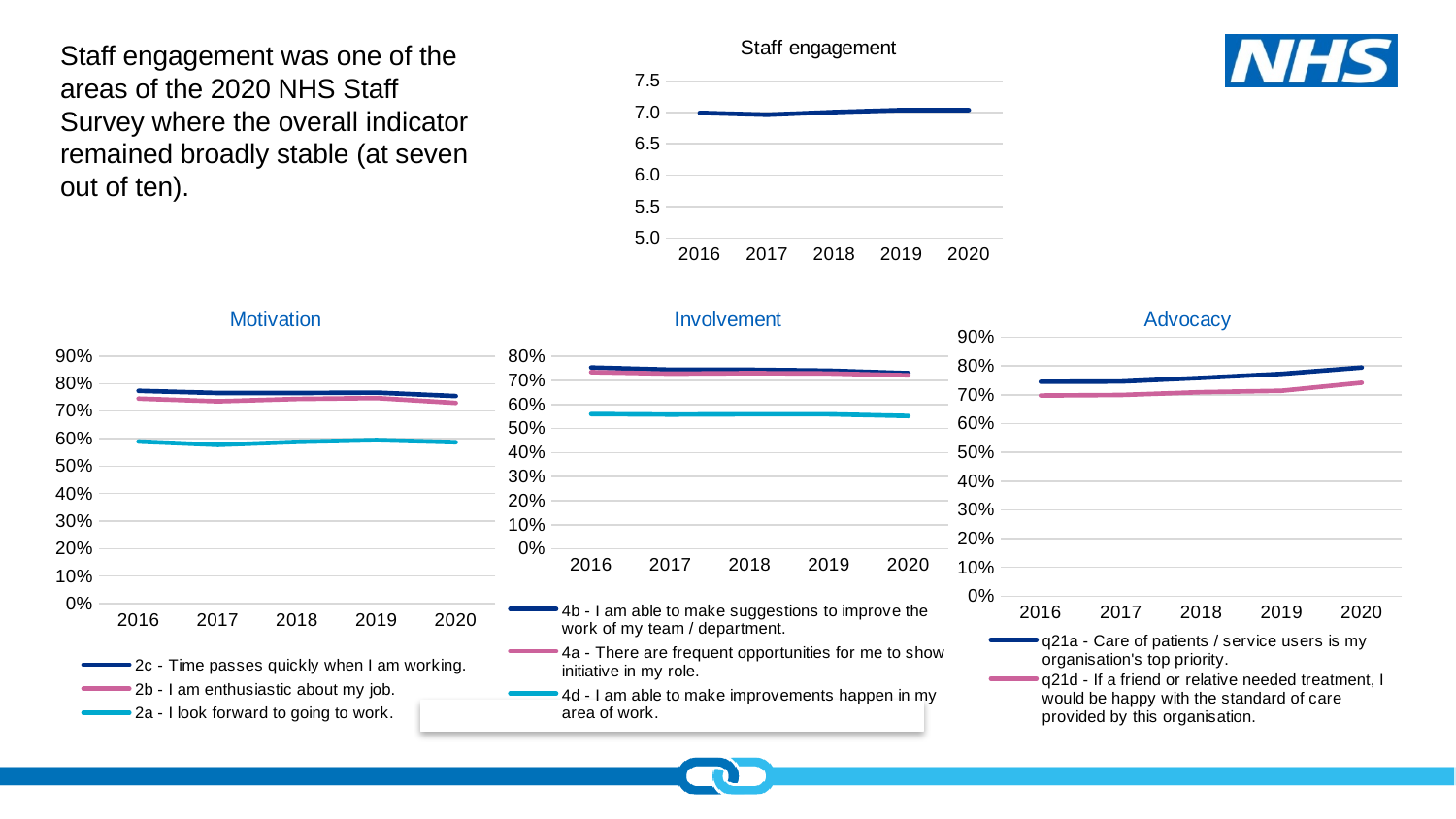
In the 'Motivation' chart, how many series does the legend list? 3 In the 'Motivation' chart, is the value for '2a - I look forward to going to work' in 2020 greater or less than 70%? less In the 'Staff engagement' chart, is the value for 2020 greater or less than 6.5? greater In the 'Involvement' chart, is the value for '4d - I am able to make improvements happen in my area of work' in 2016 greater or less than 50%? greater In the 'Motivation' chart, which series has the lowest values across all years? 2a - I look forward to going to work. In the 'Advocacy' chart, does the line for 'q21d' rise or fall from 2016 to 2020? rises In the 'Involvement' chart, which series has the lowest values across all years? 4d - I am able to make improvements happen in my area of work. In the 'Advocacy' chart, how many series does the legend list? 2 What kind of chart is the 'Staff engagement' chart at the top of the slide? Line chart In the 'Involvement' chart, how many series does the legend list? 3 In the 'Staff engagement' chart, how many years are plotted along the x axis? 5